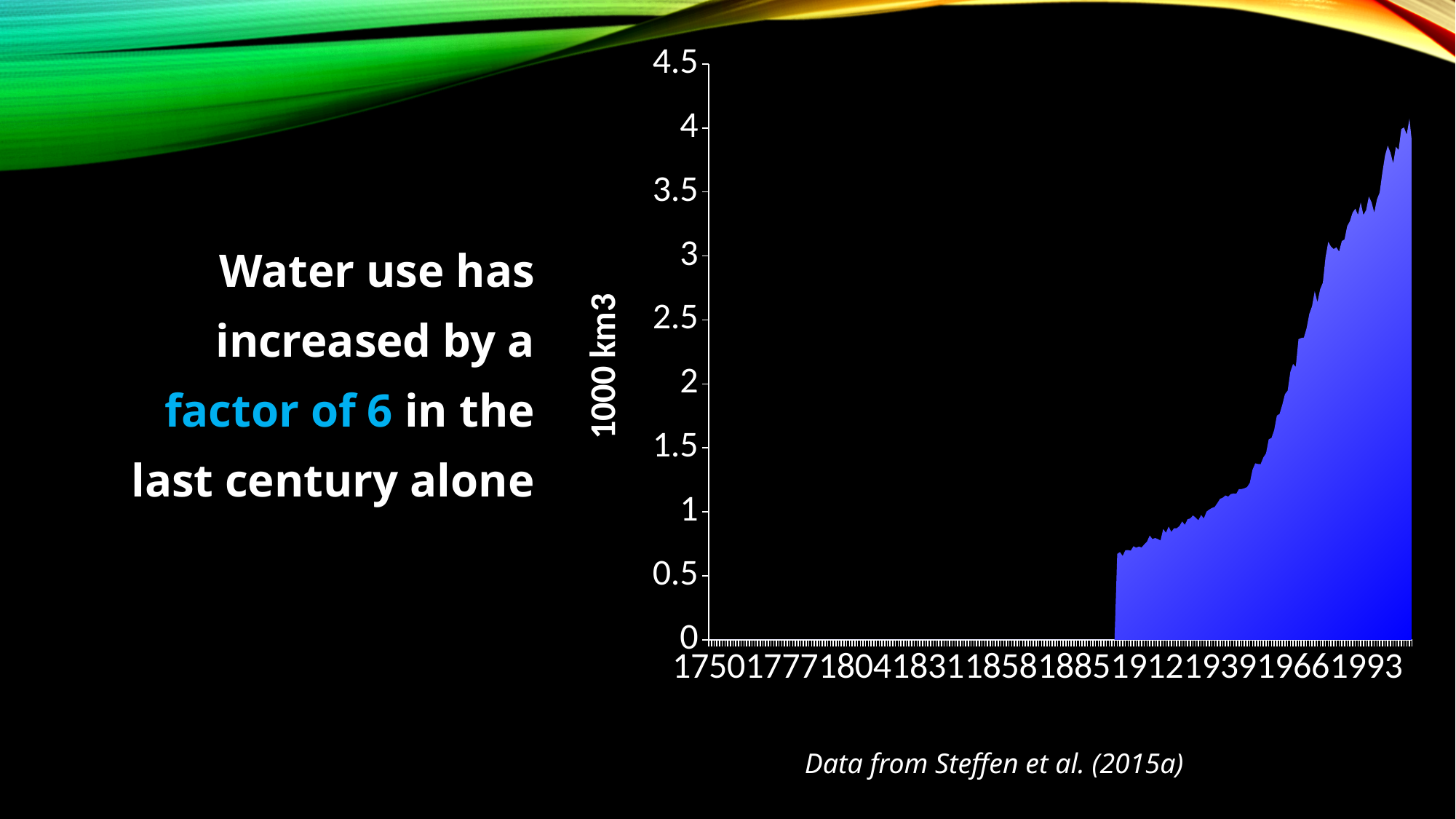
Does the plotted series reach the 4.5 tick on the vertical axis? no What is the last year label on the horizontal axis? 1993 What is the first year label on the horizontal axis? 1750 How many year labels are printed along the horizontal axis? 10 What is the label on the vertical axis of the chart? 1000 km3 Is the value for 1912 greater or less than 0.5? greater Do the plotted values rise or fall along the x axis from 1912 to the end of the series? rise What kind of chart is shown on the slide? area chart Is the value for 1912 greater or less than 1? less What is the highest tick value shown on the vertical axis? 4.5